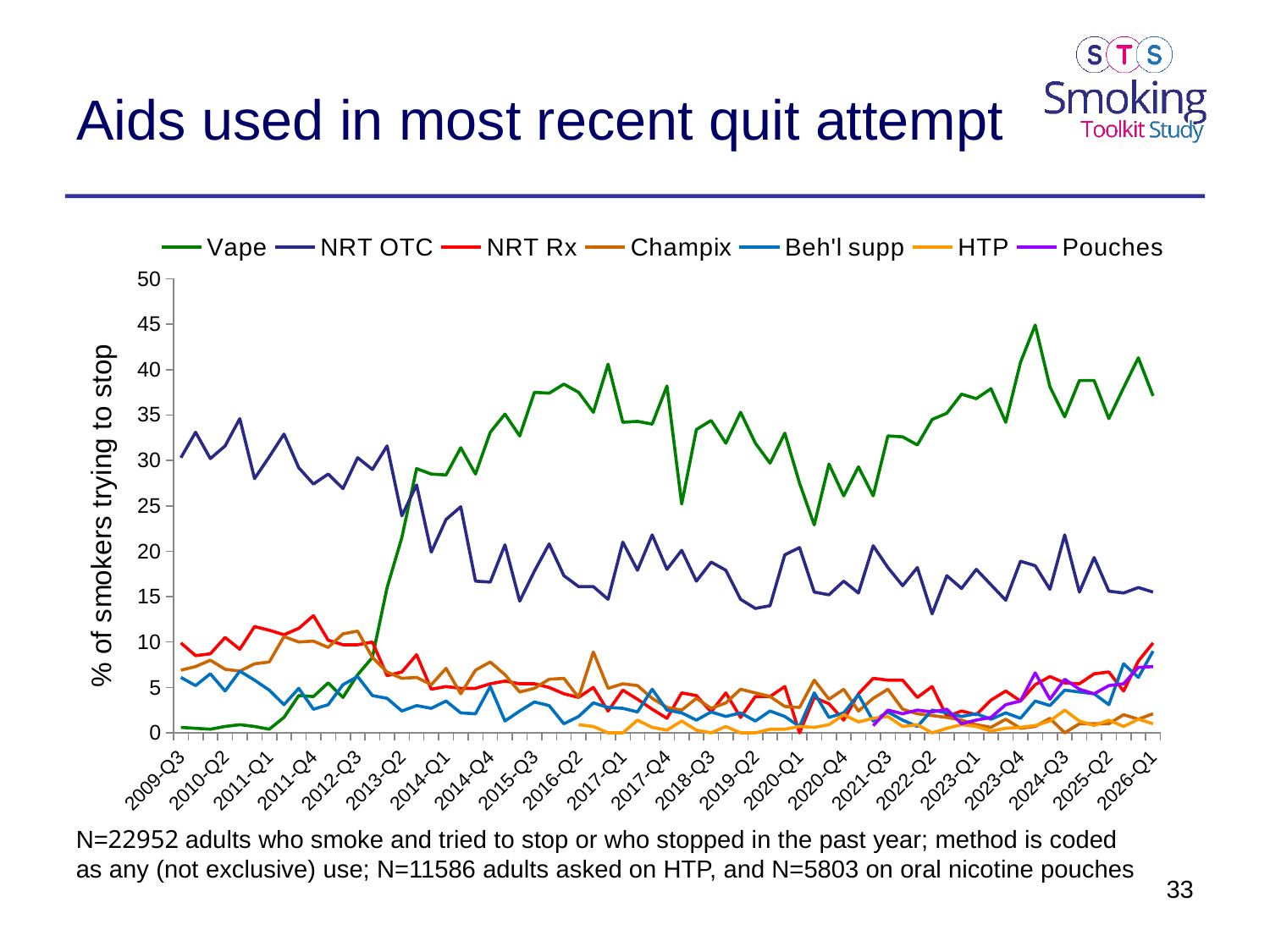
Does the Vape series rise or fall overall from 2009-Q3 to 2026-Q1? rise Is the value for Vape at 2009-Q3 greater or less than 5? less What kind of chart is shown on the slide? line chart Which series has the highest value at 2026-Q1? Vape What is the title of the vertical axis? % of smokers trying to stop What colour is the Vape line? green Is the value for NRT OTC at 2009-Q3 greater or less than 25? greater Is the value for NRT OTC at 2026-Q1 greater or less than 20? less At 2026-Q1, which is larger: Vape or NRT OTC? Vape How many series does the legend list? 7 Does the NRT OTC series rise or fall overall from 2009-Q3 to 2026-Q1? fall Which series has the highest value at 2009-Q3? NRT OTC